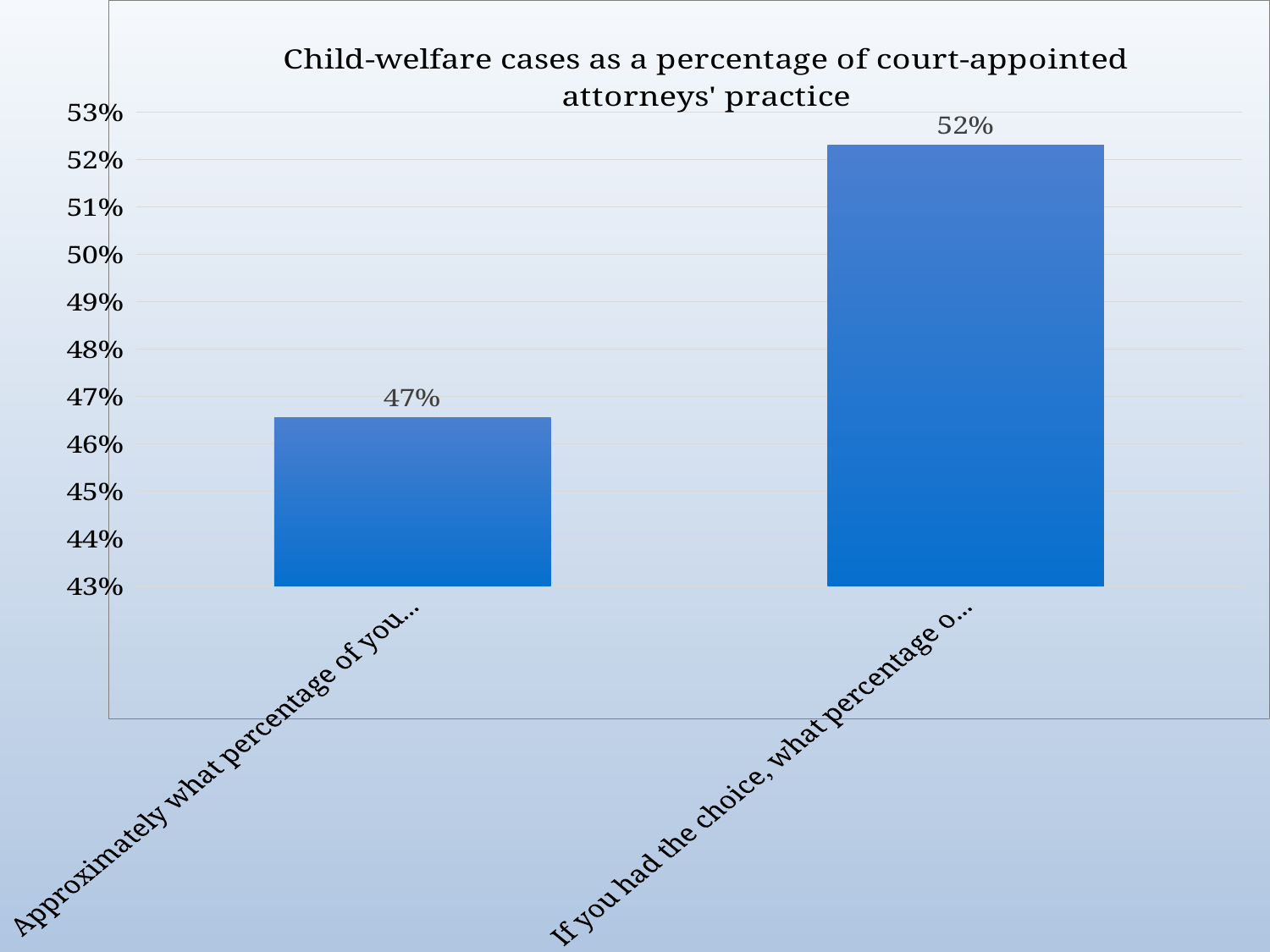
Which is larger: the left bar or the right bar? The right bar Is the value for the right bar greater or less than 50%? greater What kind of chart is shown on the slide? Bar chart What is the value of the right bar, labelled "If you had the choice, what percentage o..."? 52% What is the difference between the right bar (52%) and the left bar (47%)? 5% Which bar is the lowest? Approximately what percentage of you... Do the values rise or fall from the left bar to the right bar? Rise What is the title of the chart? Child-welfare cases as a percentage of court-appointed attorneys' practice What is the value of the left bar, labelled "Approximately what percentage of you..."? 47% How many bars are plotted in the chart? 2 Which bar is the highest? If you had the choice, what percentage o... Is the value for the left bar greater or less than 50%? less